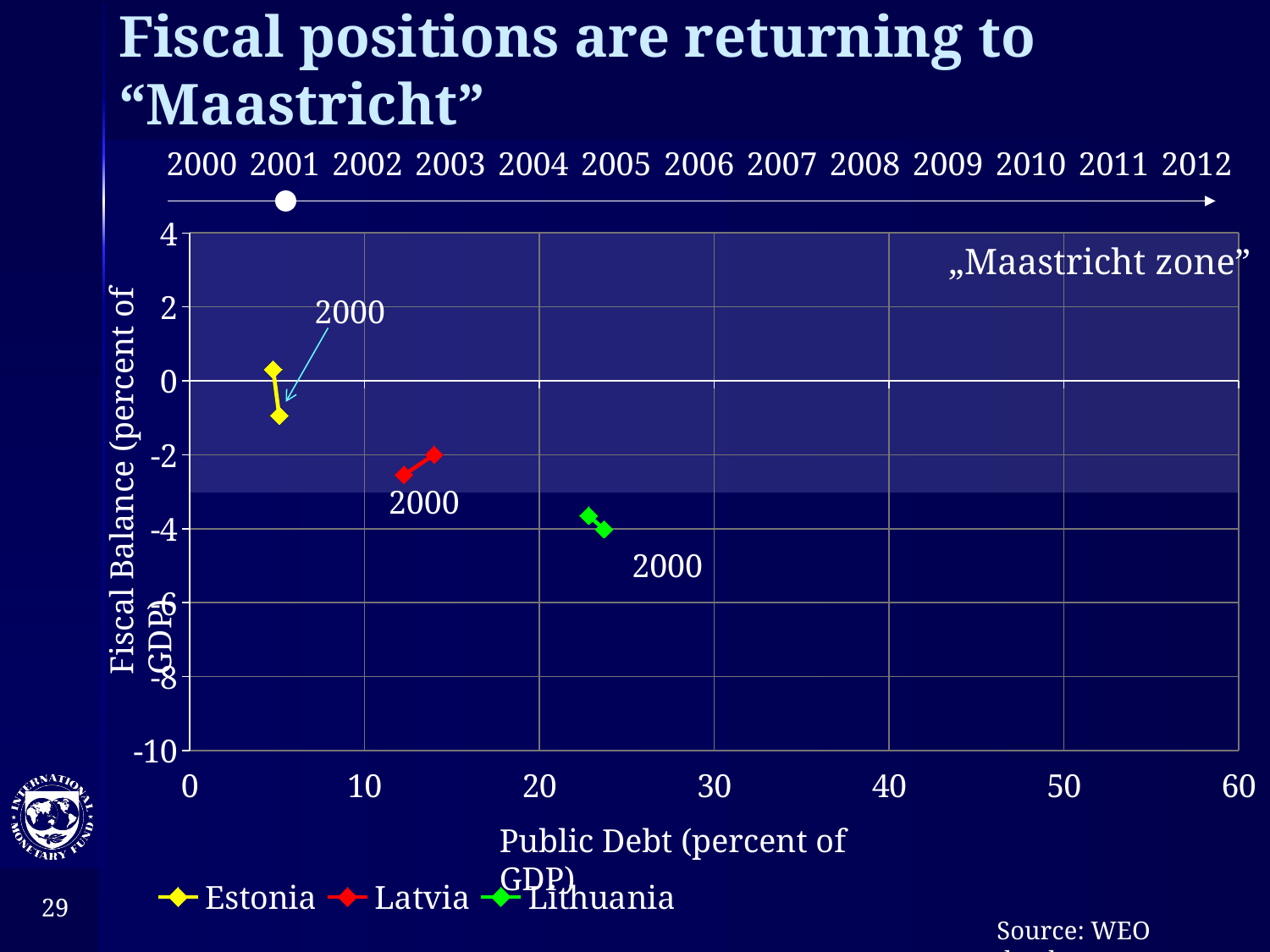
Which countries are listed in the legend? Estonia, Latvia, Lithuania Which country has the lowest public debt in the chart? Estonia What kind of chart is shown on the slide? scatter chart How many series does the legend list? 3 Is the public debt for Estonia greater or less than 10? less What is the title of the chart's horizontal axis? Public Debt (percent of GDP) Is the public debt for Lithuania greater or less than 20? greater Is the fiscal balance for Lithuania greater or less than -2? less Which has the higher public debt, Latvia or Estonia? Latvia Which country has the lowest fiscal balance in the chart? Lithuania Which country has the highest public debt in the chart? Lithuania